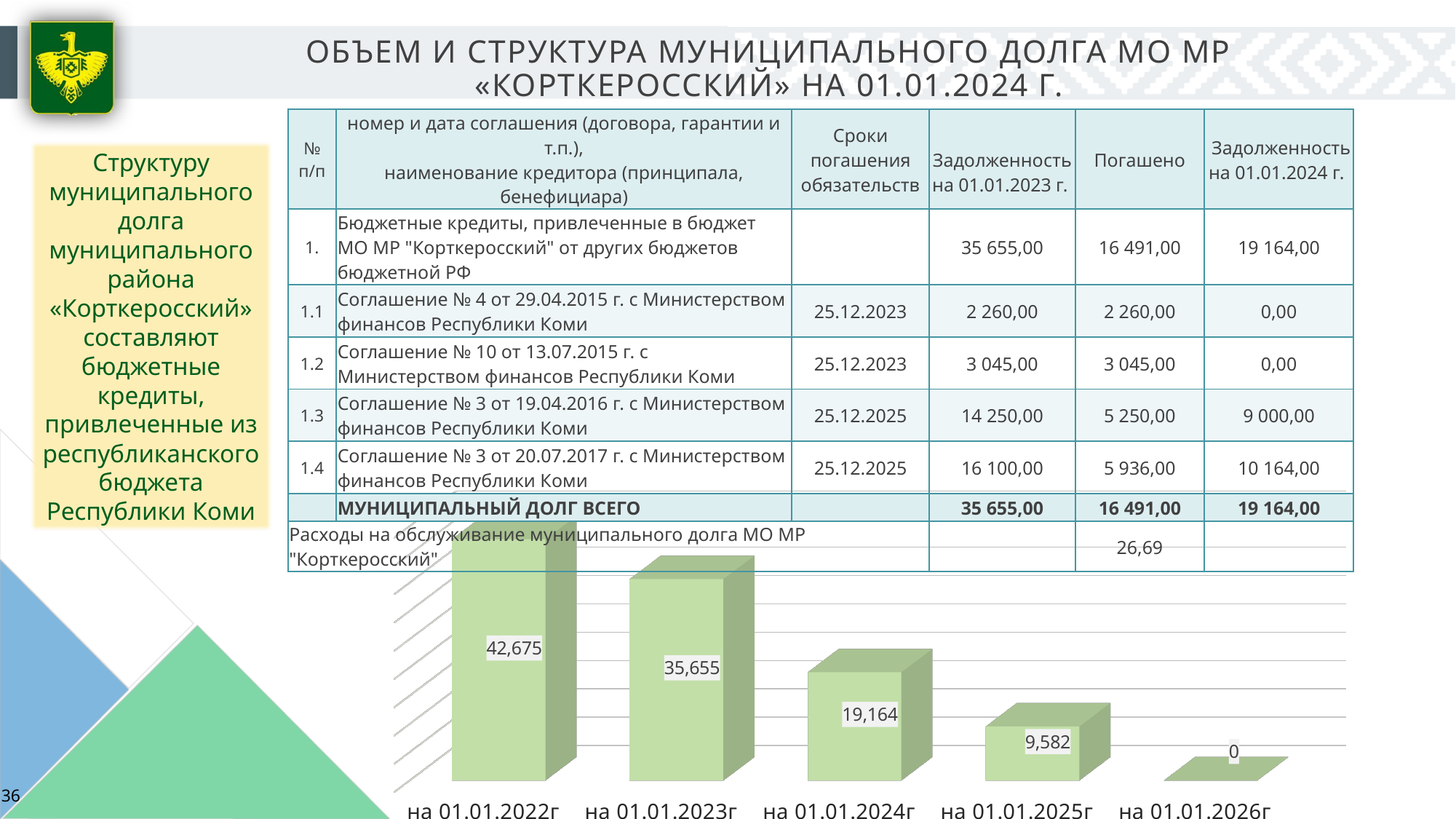
How many categories are shown in the bar chart? 5 Which category has the lowest value in the bar chart? на 01.01.2026г What is the value shown for на 01.01.2026г in the bar chart? 0 Which is larger in the bar chart: the value for на 01.01.2023г or the value for на 01.01.2024г? на 01.01.2023г What is the difference between the values for на 01.01.2022г and на 01.01.2023г in the bar chart? 7,020 What is the value shown for на 01.01.2024г in the bar chart? 19,164 Which category has the highest value in the bar chart? на 01.01.2022г What is the value shown for на 01.01.2023г in the bar chart? 35,655 What is the value shown for на 01.01.2022г in the bar chart? 42,675 What is the difference between the values for на 01.01.2024г and на 01.01.2025г in the bar chart? 9,582 What is the value shown for на 01.01.2025г in the bar chart? 9,582 Do the values in the bar chart rise or fall from left to right along the x axis? fall